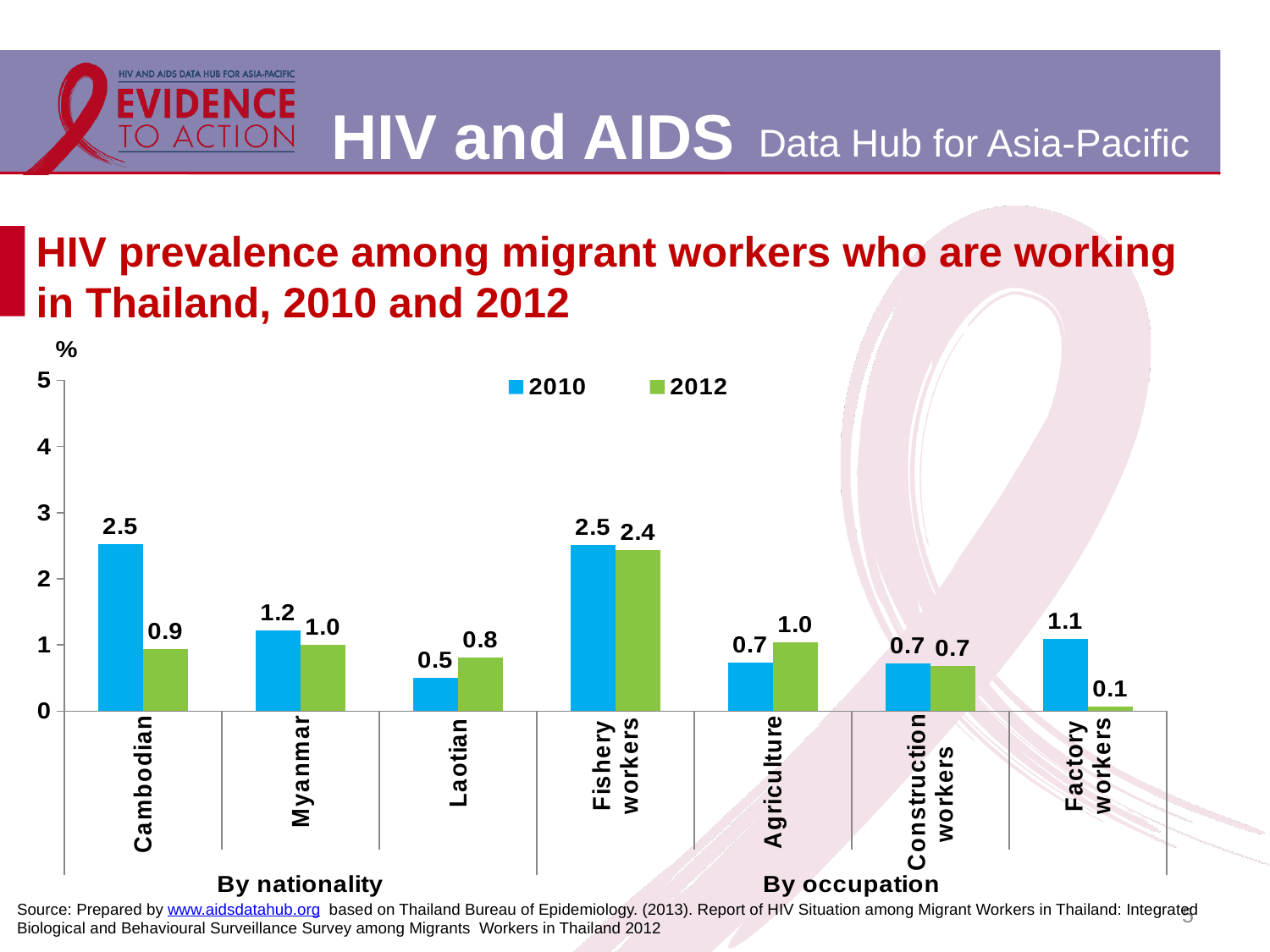
By how much did HIV prevalence among Cambodian migrant workers fall from 2010 to 2012? 1.6 What was the HIV prevalence among factory workers in 2012? 0.1 Which colour represents the 2012 series in the chart? Green What was the HIV prevalence among Laotian migrant workers in 2012? 0.8 Which category had the lowest HIV prevalence in 2012? Factory workers What kind of chart is shown on the slide? Bar chart How many categories are shown on the x axis? 7 What is the difference between the 2010 and 2012 values for fishery workers? 0.1 Which category had the highest HIV prevalence in 2012? Fishery workers Which was higher for agriculture workers, the 2010 value or the 2012 value? 2012 What was the HIV prevalence among Cambodian migrant workers in 2010? 2.5 How many series does the legend list? 2